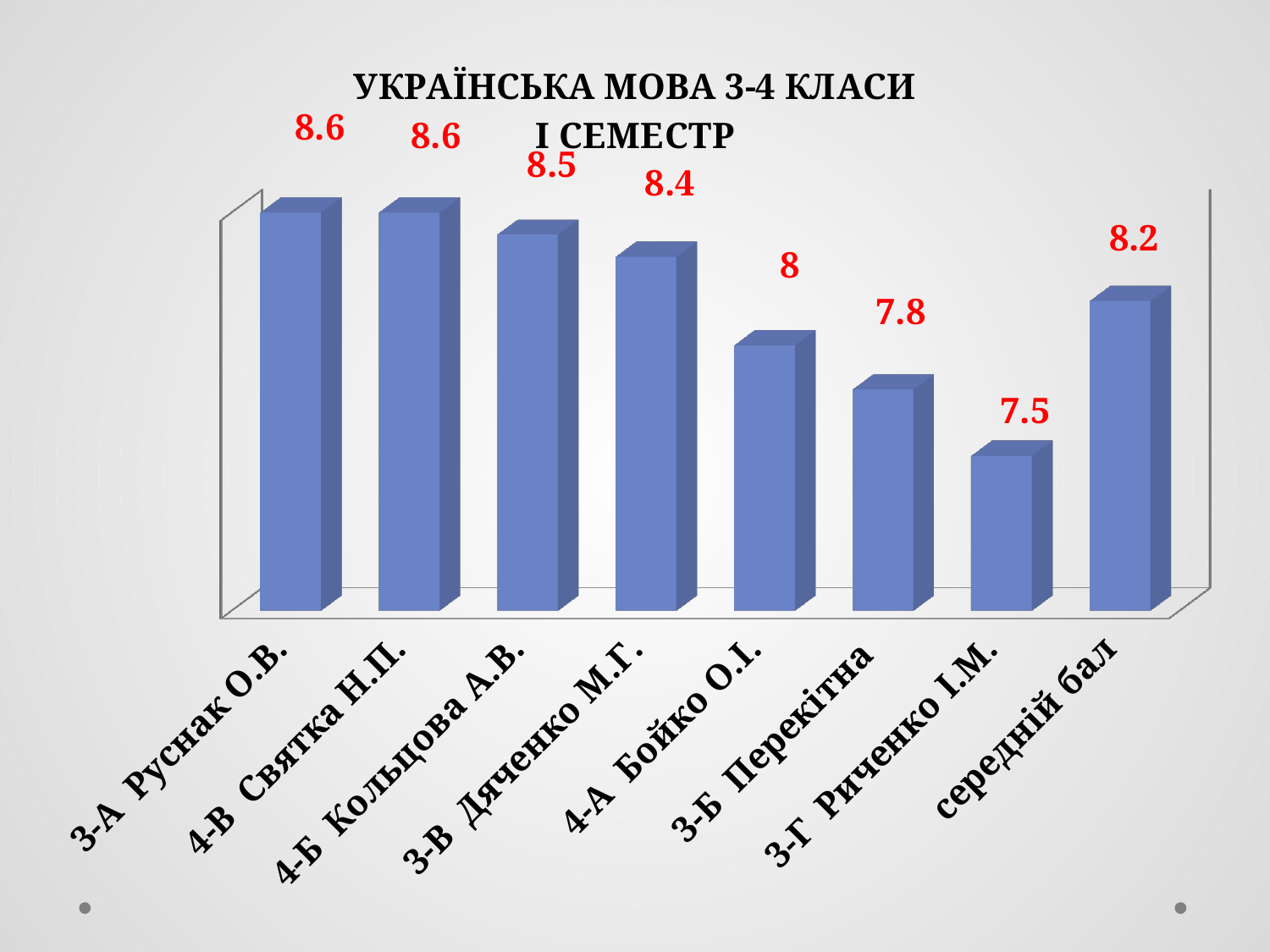
Which is larger, the value for середній бал or the value for 3-В Дяченко М.Г.? 3-В Дяченко М.Г. What is the difference between the values for 3-В Дяченко М.Г. and 3-Г Риченко І.М.? 0.9 How many categories are shown on the chart? 8 Which category has the lowest value? 3-Г Риченко І.М. What is the value for 4-А Бойко О.І.? 8 What is the value for 3-Г Риченко І.М.? 7.5 Which is larger, the value for 4-А Бойко О.І. or the value for 3-Б Перекітна? 4-А Бойко О.І. What is the value for 4-Б Кольцова А.В.? 8.5 What is the value shown for середній бал? 8.2 What is the title of the chart? УКРАЇНСЬКА МОВА 3-4 КЛАСИ І СЕМЕСТР What kind of chart is shown on the slide? Bar chart What is the difference between the values for 3-А Руснак О.В. and 3-Б Перекітна? 0.8